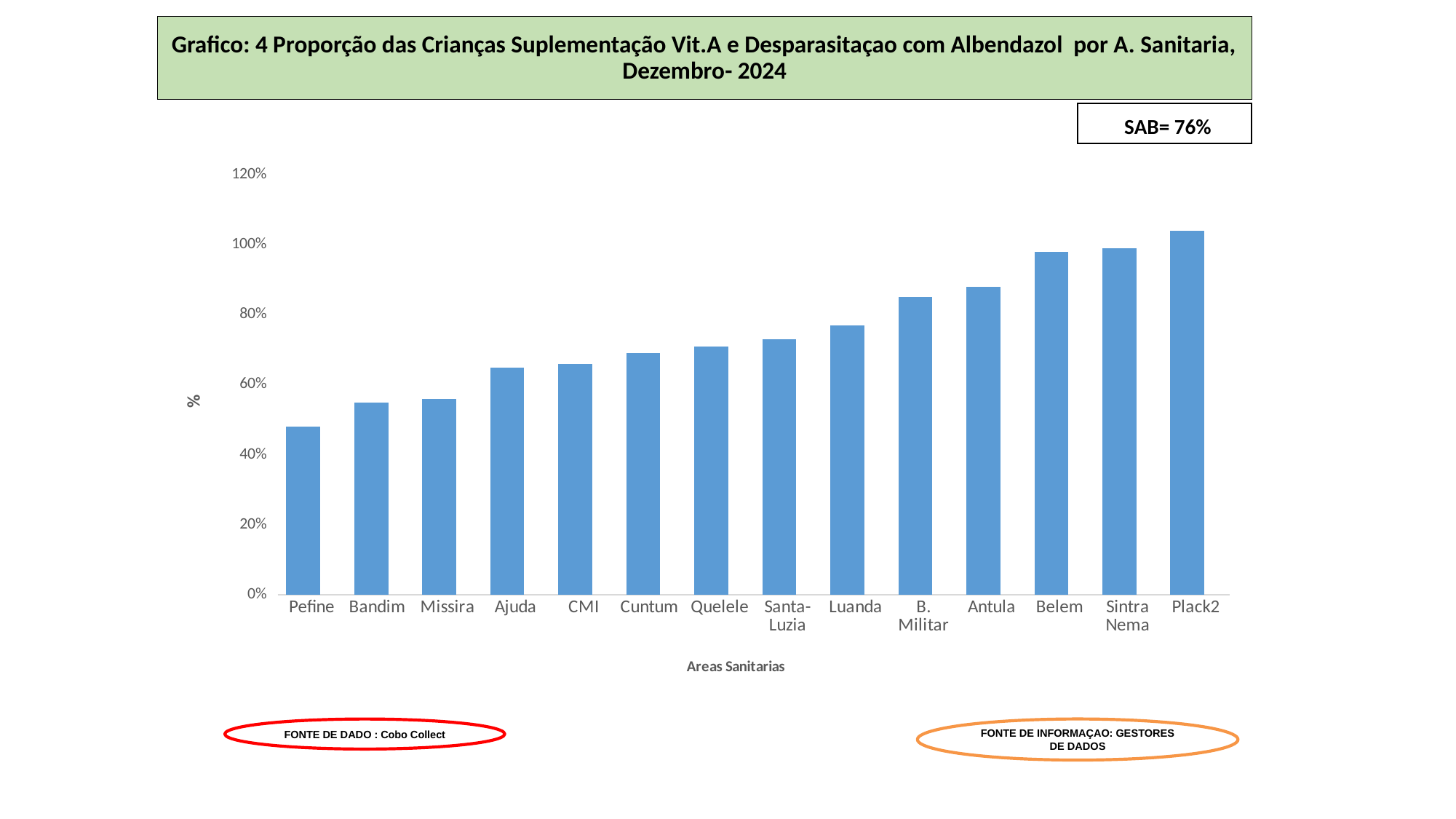
How many areas sanitarias (categories) are plotted on the chart? 14 Which area sanitaria has the highest proportion? Plack2 What kind of chart is shown on the slide? bar chart Is the value for B. Militar greater or less than 80%? greater What is the title of the x axis? Areas Sanitarias Which has a larger value, Antula or Ajuda? Antula Which area sanitaria has the lowest proportion? Pefine Do the values rise or fall moving from left to right along the x axis? rise Is the value for Pefine greater or less than 60%? less Is the value for Ajuda greater or less than 60%? greater What SAB value is shown in the box above the chart? SAB= 76%